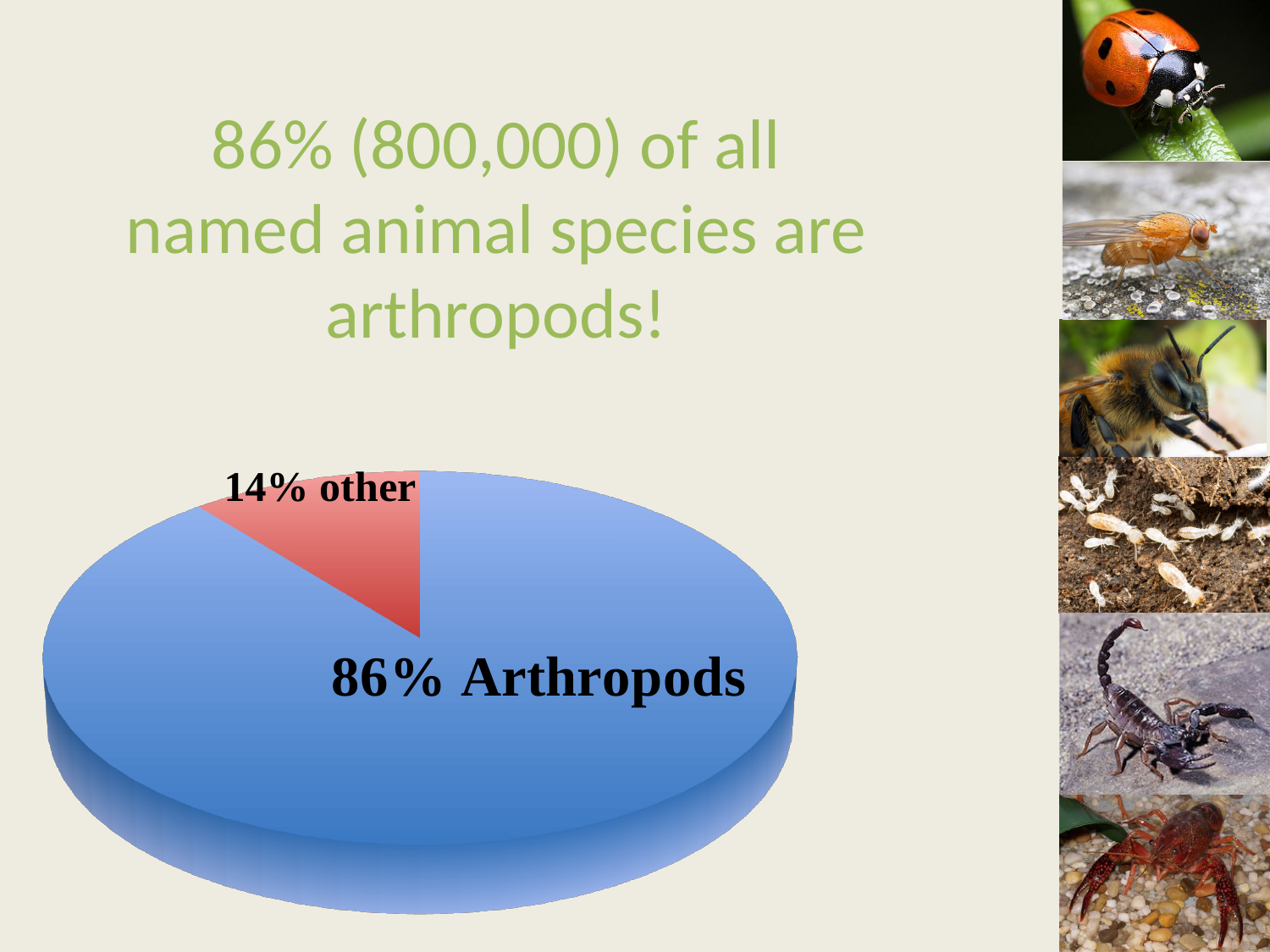
What colour is the Arthropods slice of the pie? blue What is the difference in percentage points between the Arthropods slice and the other slice? 72 How many slices does the pie chart have? 2 Which is larger, the Arthropods slice or the other slice? Arthropods Which slice of the pie is the smallest? other What kind of chart is shown on the slide? pie chart What share of the pie is labelled Arthropods? 86% Which slice of the pie is the largest? Arthropods What colour is the other slice of the pie? red What is the total of the two slice percentages shown on the pie? 100% What share of the pie is labelled other? 14%